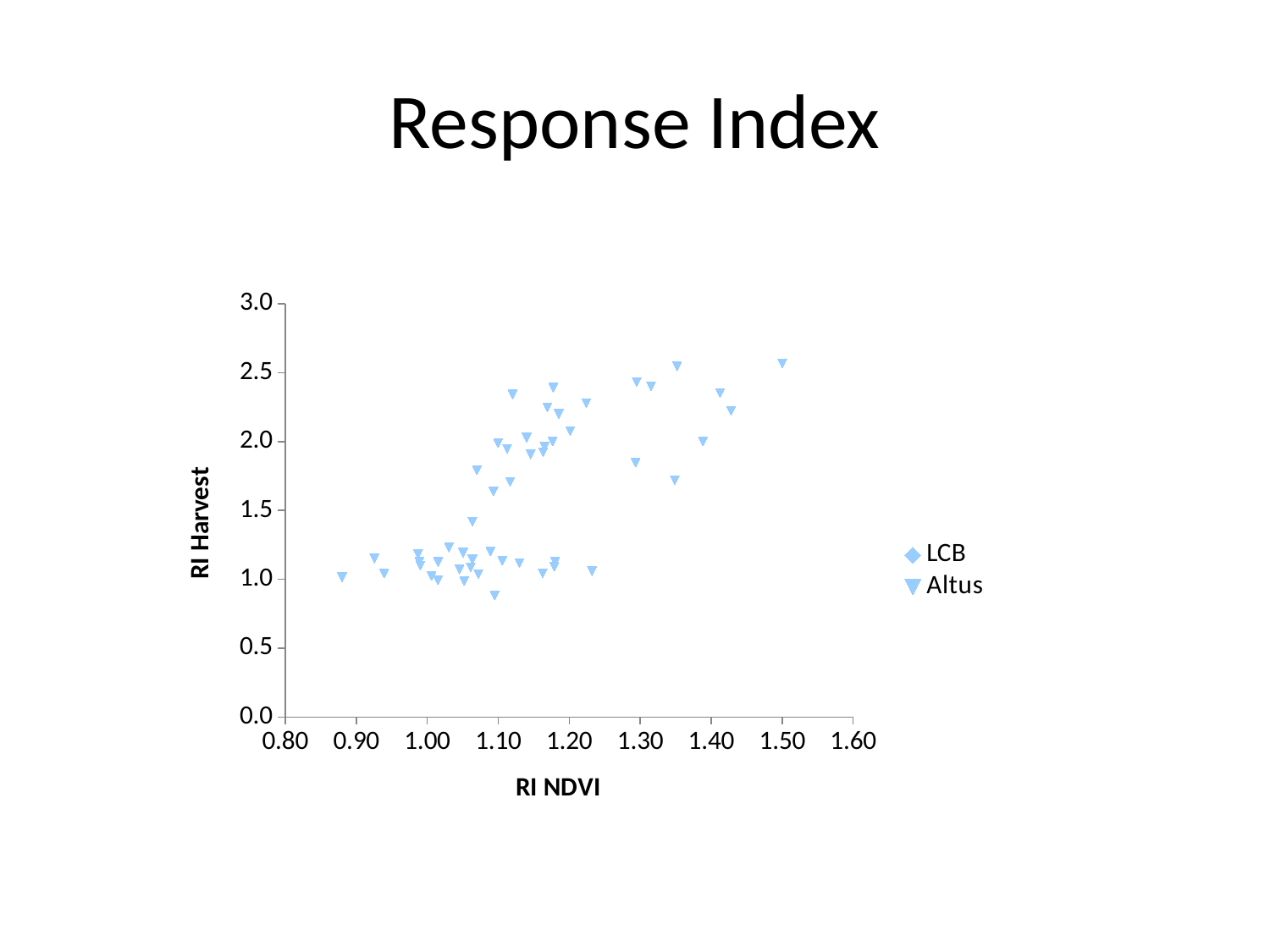
Is the RI Harvest value of the rightmost point (at RI NDVI about 1.50) greater or less than 2.0? greater How many series does the legend list? 2 Is the largest RI NDVI value plotted greater or less than 1.40? greater Is the highest RI Harvest value plotted greater or less than 3.0? less What kind of chart is shown on the slide? scatter chart What are the two series named in the legend? LCB and Altus Do the RI Harvest values generally rise or fall as RI NDVI increases? rise What is the title of the chart? Response Index